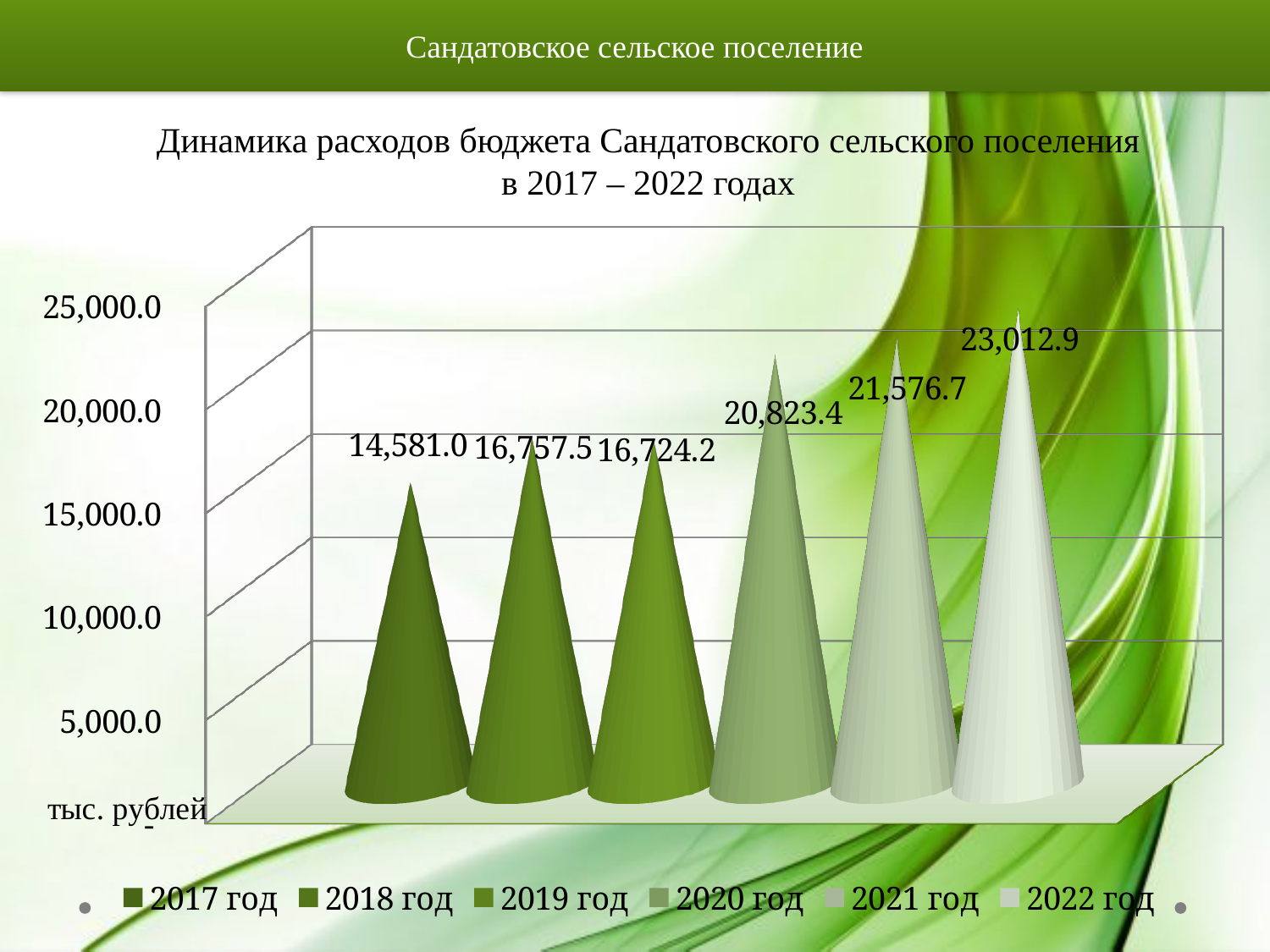
What is the value for 2019 год? 16,724.2 What is the value for 2022 год? 23,012.9 Do the values generally rise or fall from 2017 to 2022? rise Which year has the lowest value? 2017 год Which is larger, the value for 2018 год or the value for 2019 год? 2018 год What unit is shown on the chart's vertical axis? тыс. рублей Which year has the highest value? 2022 год What is the value for 2017 год? 14,581.0 What is the value for 2020 год? 20,823.4 What is the difference between the values for 2022 год and 2017 год? 8,431.9 What is the difference between the values for 2021 год and 2020 год? 753.3 How many series does the legend list? 6